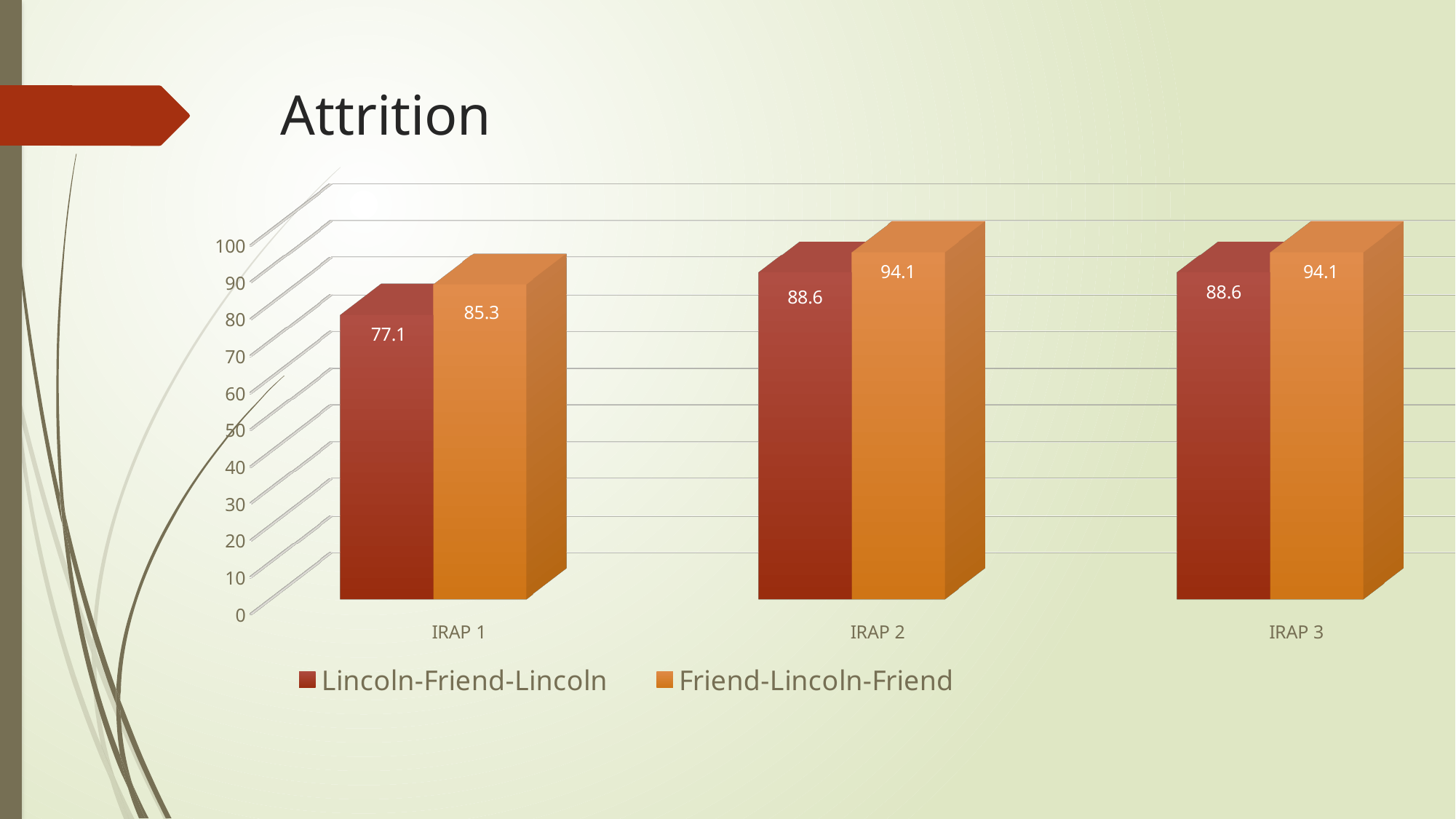
Which series has the larger value at IRAP 3, Lincoln-Friend-Lincoln or Friend-Lincoln-Friend? Friend-Lincoln-Friend How many categories are shown on the x axis? 3 What is the value for Friend-Lincoln-Friend at IRAP 3? 94.1 How many series does the legend list? 2 What is the difference between the Friend-Lincoln-Friend and Lincoln-Friend-Lincoln values at IRAP 2? 5.5 What is the difference between the Friend-Lincoln-Friend and Lincoln-Friend-Lincoln values at IRAP 1? 8.2 What is the title of the slide? Attrition What is the value for Lincoln-Friend-Lincoln at IRAP 1? 77.1 What is the value for Lincoln-Friend-Lincoln at IRAP 2? 88.6 What kind of chart is shown on the slide? Bar chart What is the value for Friend-Lincoln-Friend at IRAP 1? 85.3 Which category has the lowest value for Lincoln-Friend-Lincoln? IRAP 1